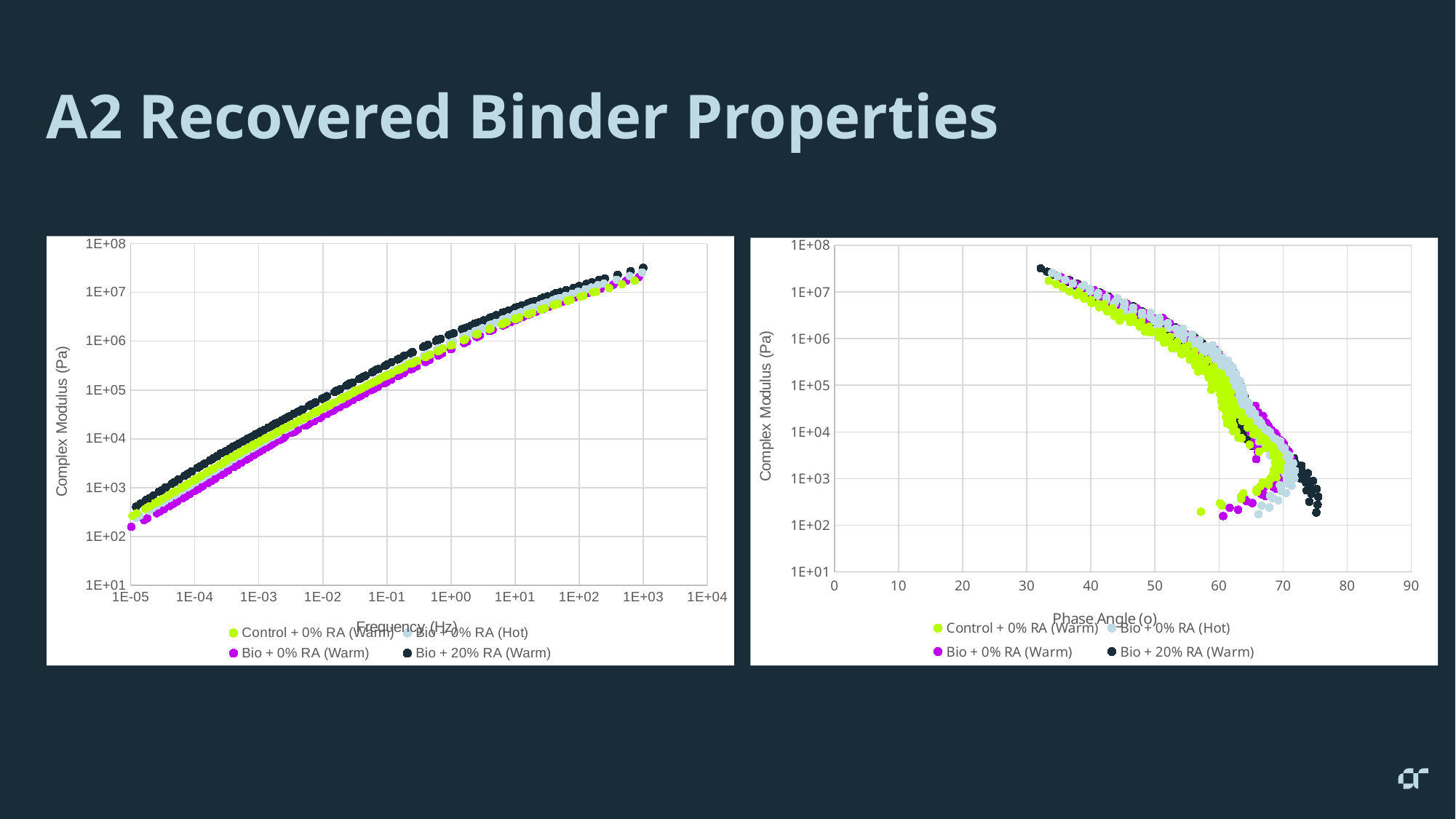
What kind of chart is the left chart (Complex Modulus vs Frequency)? scatter chart In the left chart, which series has the highest complex modulus at the lowest frequencies? Bio + 20% RA (Warm) How many series does the legend of the left chart list? 4 In the left chart, does the complex modulus rise or fall as frequency increases? rise What kind of chart is the right chart (Complex Modulus vs Phase Angle)? scatter chart In the left chart, which series has the lowest complex modulus at the lowest frequencies? Bio + 0% RA (Warm) In the right chart, does the complex modulus rise or fall as the phase angle increases? fall In the right chart, which series reaches the highest phase angle? Bio + 20% RA (Warm) In the right chart, is the highest phase angle reached by Bio + 20% RA (Warm) greater or less than 70? greater In the left chart, at the highest frequency plotted, is the complex modulus of Bio + 20% RA (Warm) greater or less than 1E+07? greater What is the y-axis label of the right chart? Complex Modulus (Pa) What is the x-axis label of the left chart? Frequency (Hz)